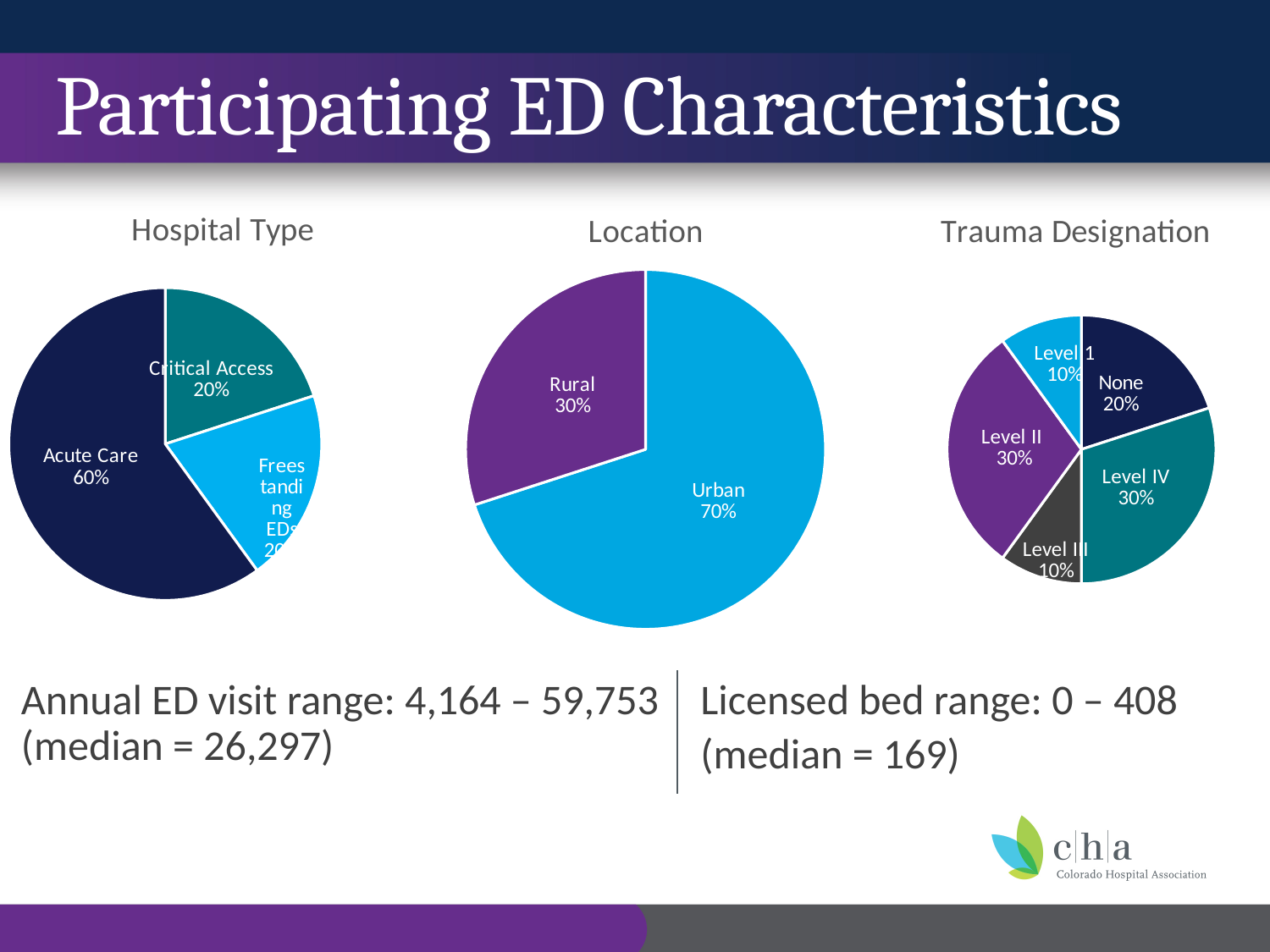
In the Trauma Designation chart, what percentage of EDs are Level II? 30% In the Trauma Designation chart, how many categories are shown? 5 In the Location chart, what percentage of EDs are Urban? 70% In the Location chart, what is the difference between the Urban and Rural shares? 40% In the Trauma Designation chart, which is larger, Level IV or Level III? Level IV In the Hospital Type chart, what share of participating EDs are Acute Care? 60% In the Location chart, what percentage of EDs are Rural? 30% In the Hospital Type chart, what percentage is Critical Access? 20% In the Hospital Type chart, which hospital type has the largest slice? Acute Care What type of chart is used for the Location data? Pie chart In the Trauma Designation chart, what percentage of EDs have no trauma designation (None)? 20% How many pie charts are shown on the slide? 3